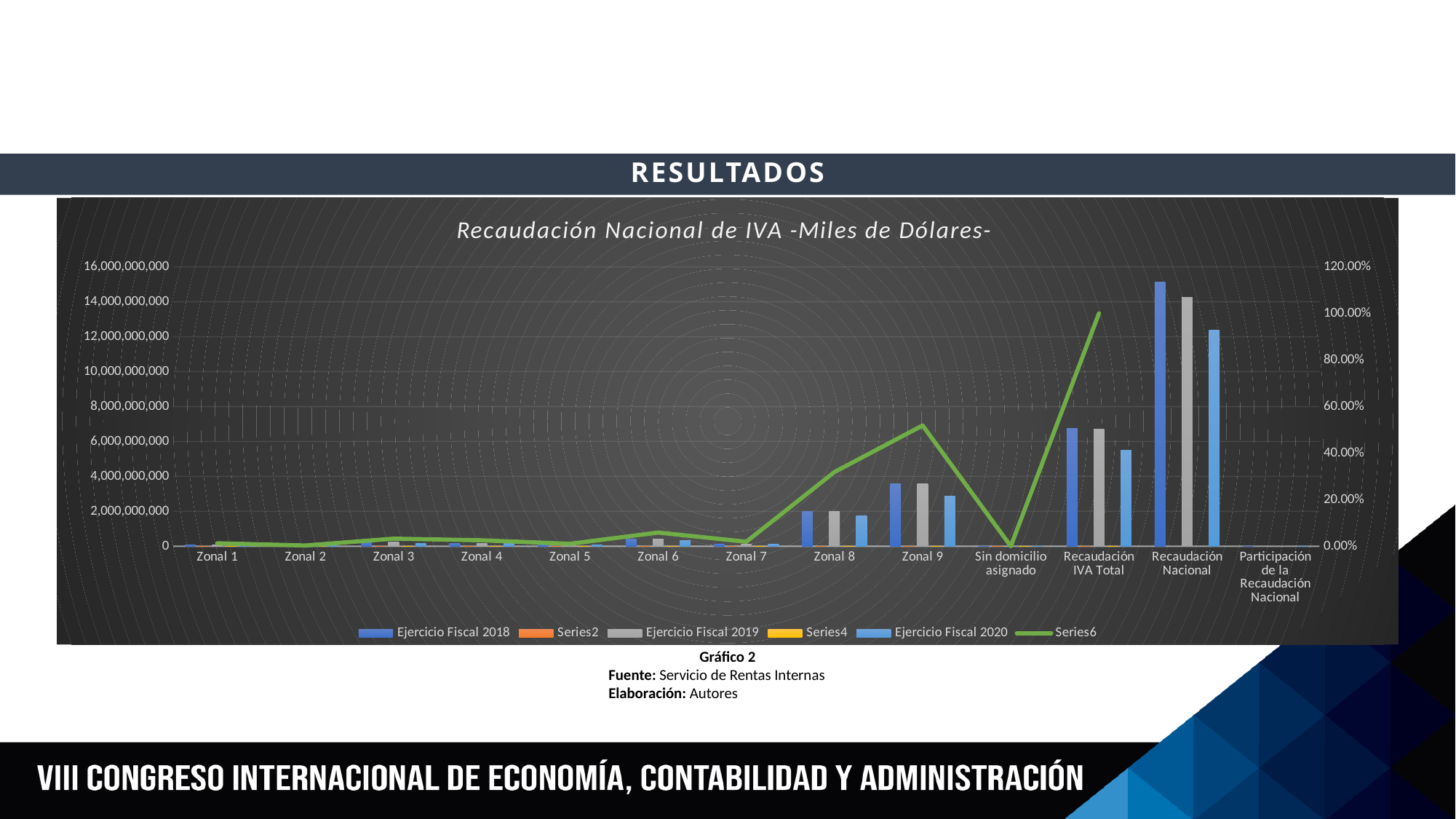
How many categories are shown on the x axis? 13 What is the title of the chart? Recaudación Nacional de IVA -Miles de Dólares- What kind of chart is shown on the slide? Combined bar and line chart How many series does the legend list? 6 Is the Ejercicio Fiscal 2018 value for Recaudación IVA Total greater or less than 6,000,000,000? greater Is the Ejercicio Fiscal 2018 value for Recaudación Nacional greater or less than 14,000,000,000? greater Is the Ejercicio Fiscal 2020 value for Zonal 8 greater or less than 2,000,000,000? less Which category has the tallest bar for Ejercicio Fiscal 2018? Recaudación Nacional Which has the larger Ejercicio Fiscal 2018 value, Zonal 8 or Zonal 9? Zonal 9